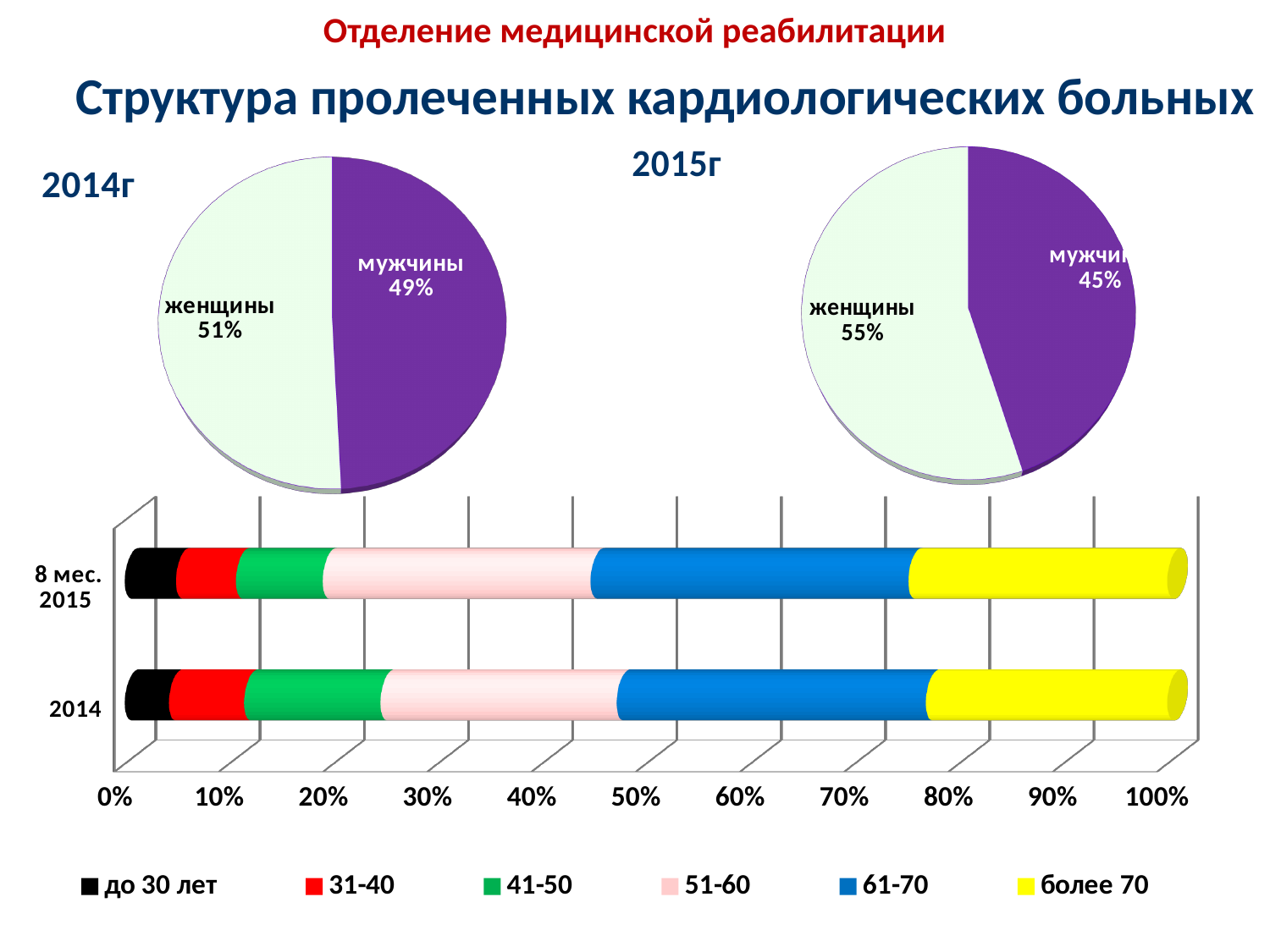
What kind of chart is shown at the bottom of the slide? stacked bar chart How many categories (bars) does the stacked bar chart at the bottom of the slide show? 2 In the 2015г pie chart, which slice is larger, женщины or мужчины? женщины In the 2015г pie chart, what is the difference between the женщины and мужчины shares? 10% In the stacked bar chart at the bottom of the slide, is the cumulative share up to the end of the 51-60 segment for 2014 greater or less than 40%? greater In the stacked bar chart at the bottom of the slide, which series is shown in yellow? более 70 In the 2014г pie chart, what share is labelled for женщины? 51% How many series does the legend of the stacked bar chart at the bottom of the slide list? 6 In the 2014г pie chart, what share is labelled for мужчины? 49% What is the difference between the женщины share in the 2015г pie chart and the женщины share in the 2014г pie chart? 4% In the 2015г pie chart, what share is labelled for женщины? 55% In the 2015г pie chart, what share is labelled for мужчины? 45%